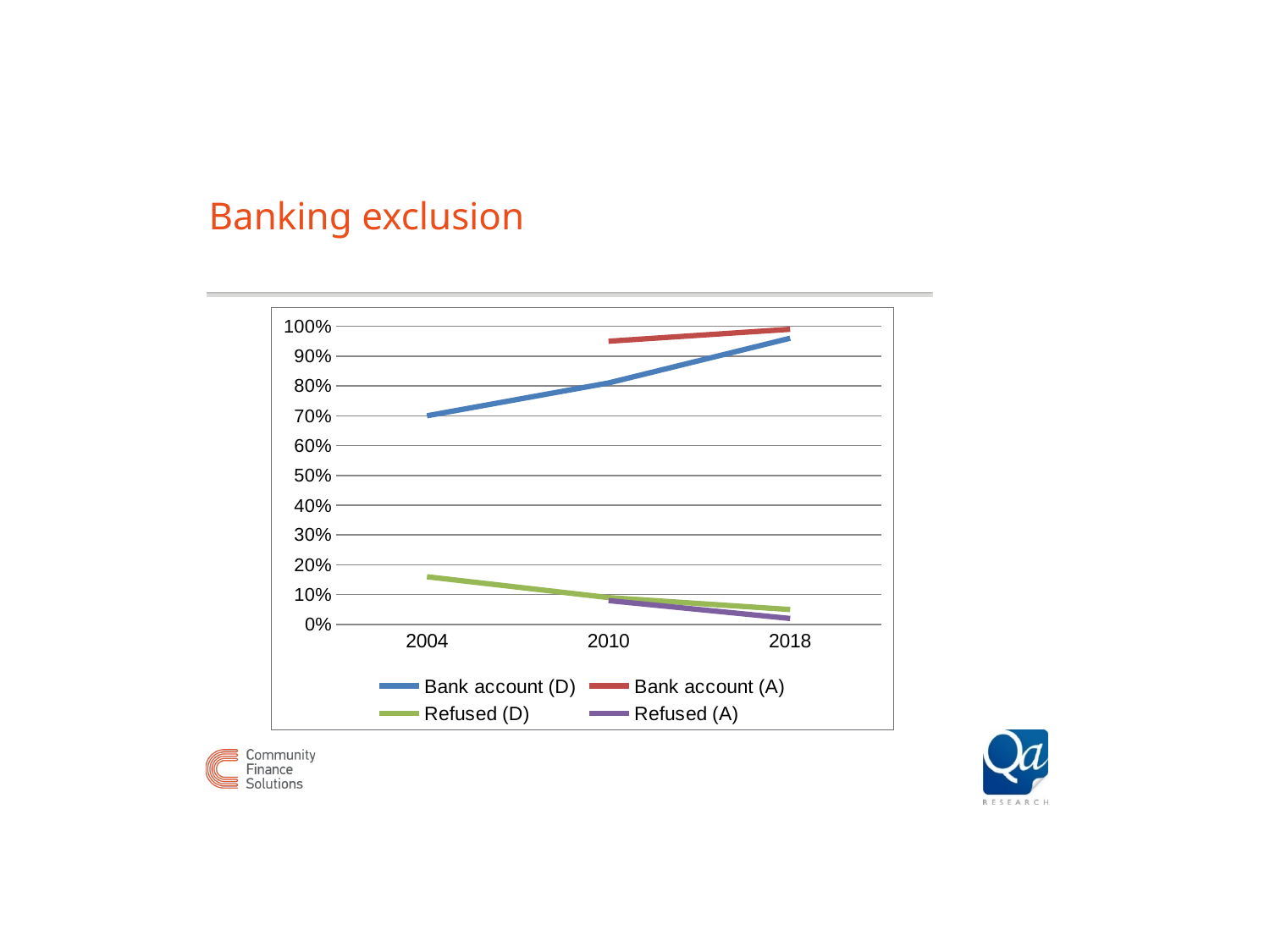
How many years are shown on the x axis? 3 Which series has the highest value in 2010? Bank account (A) Is the value for Refused (D) in 2004 greater or less than 20%? less Is the value for Refused (A) in 2018 greater or less than 10%? less In 2018, which is higher: Bank account (A) or Bank account (D)? Bank account (A) How many series does the legend list? 4 What kind of chart is shown on the slide? line chart Is the value for Bank account (D) in 2018 greater or less than 90%? greater Does the Bank account (D) line rise or fall from 2004 to 2018? rise Does the Refused (D) line rise or fall from 2004 to 2018? fall What is the title of the slide? Banking exclusion